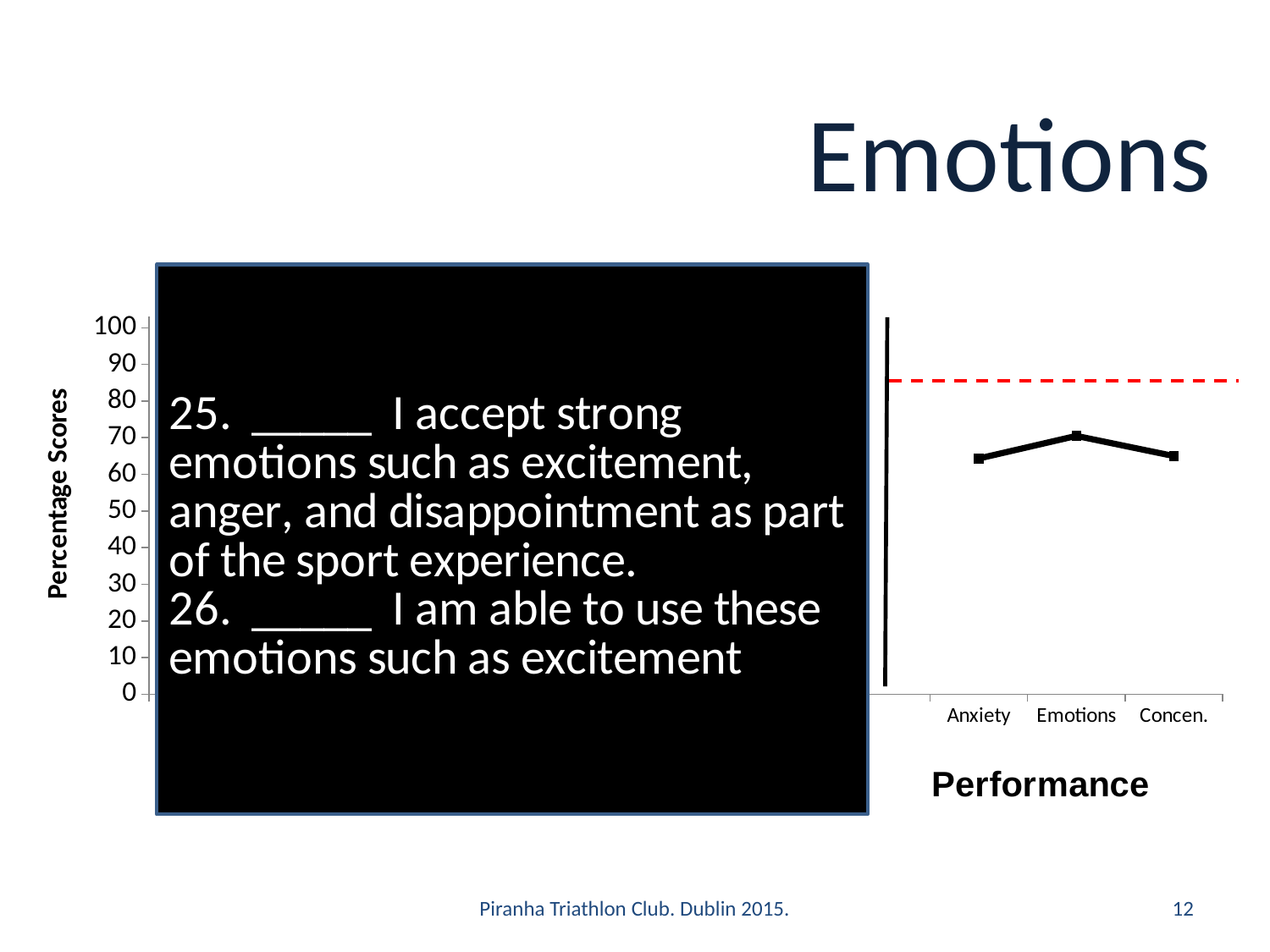
Is the value for Concen. greater or less than 70? less What is the label of the vertical axis of the chart? Percentage Scores Is the value for Anxiety greater or less than 70? less What kind of chart is shown on the slide? line chart Which is larger, the value for Emotions or the value for Anxiety? Emotions Is the value for Anxiety greater or less than 50? greater How many category labels are visible on the x axis of the chart? 3 What is the label shown beneath the x axis of the chart? Performance Which of the visible categories (Anxiety, Emotions, Concen.) has the highest value? Emotions